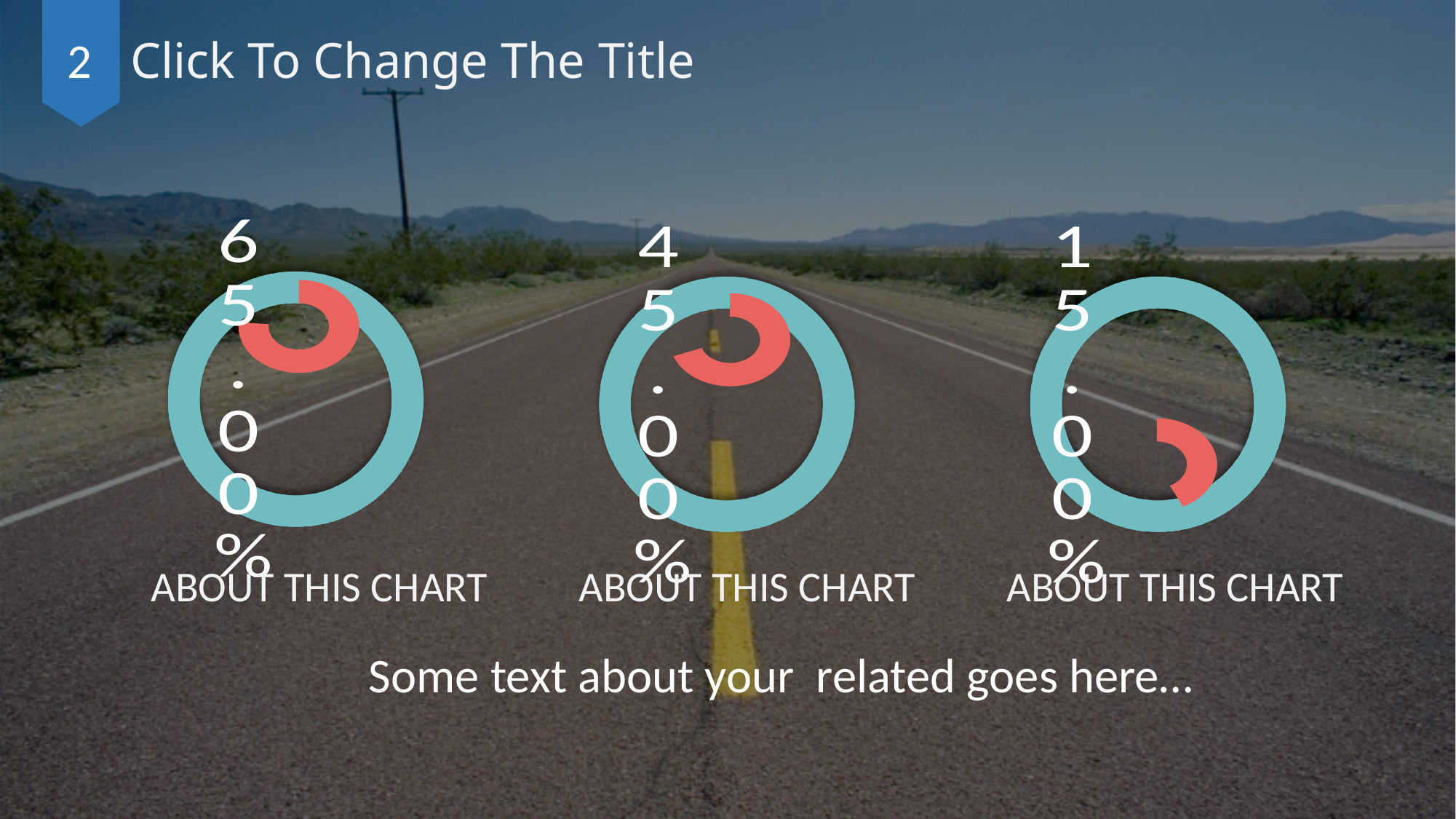
Which of the three charts shows the lowest printed value? The right chart (15.00%) Which is larger, the value on the middle chart or the value on the right chart? The middle chart (45.00%) What colour is the outer ring of each chart? Teal What caption appears below each of the three charts? ABOUT THIS CHART Which of the three charts shows the highest printed value? The left chart (65.00%) What is the difference between the value on the middle chart and the value on the right chart? 30.00% How many charts are shown on the slide? 3 What value is printed on the right chart? 15.00% What is the difference between the value on the left chart and the value on the middle chart? 20.00% What value is printed on the left chart? 65.00% What kind of chart is used for each of the three figures on the slide? Donut chart What value is printed on the middle chart? 45.00%